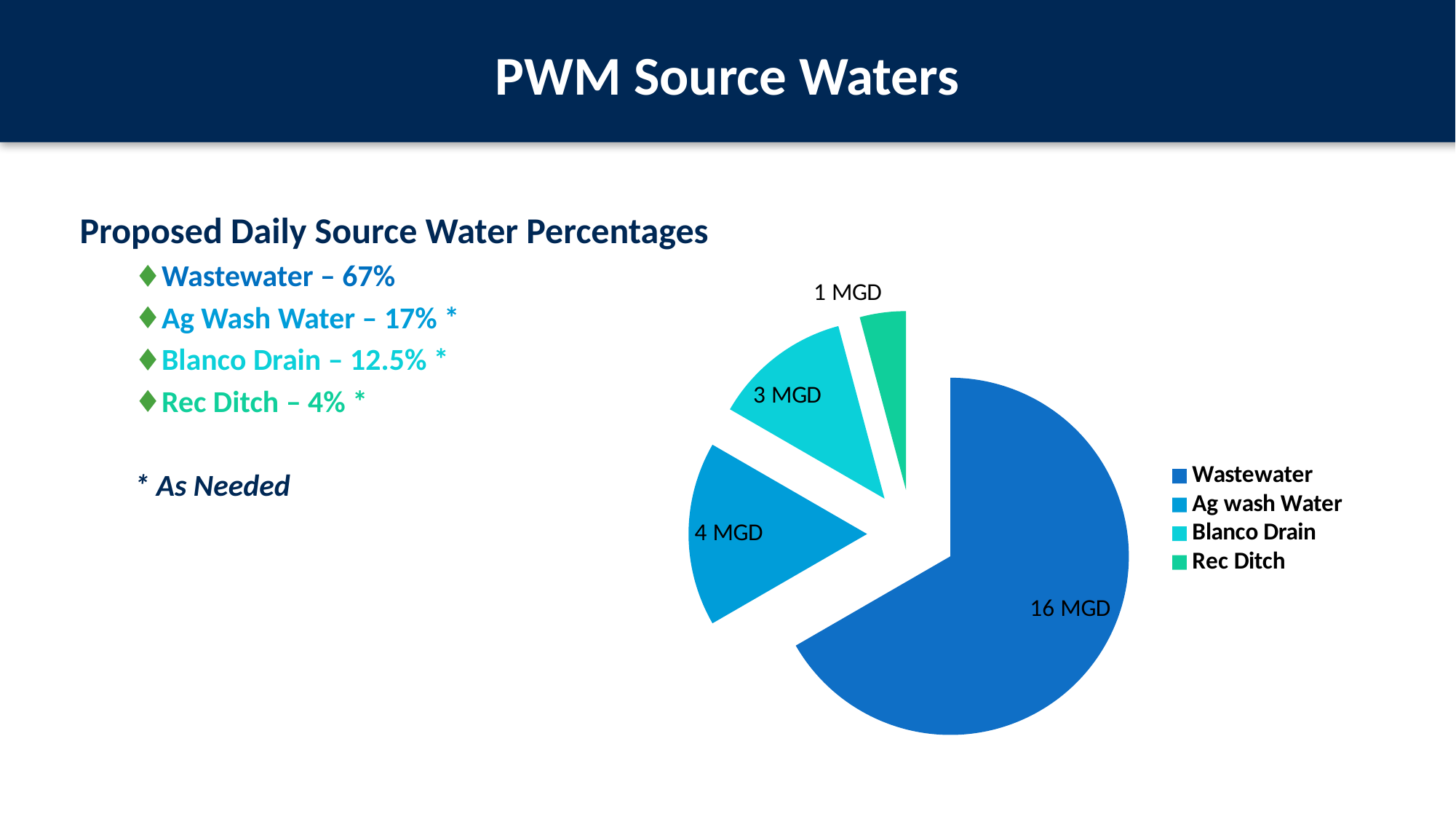
What is the value for Blanco Drain in the pie chart? 3 MGD How many slices does the pie chart have? 4 What is the value for Wastewater in the pie chart? 16 MGD Which is larger in the pie chart, Blanco Drain or Rec Ditch? Blanco Drain What is the value for Ag wash Water in the pie chart? 4 MGD Which source water has the largest slice in the pie chart? Wastewater What is the difference between the Wastewater and Ag wash Water values in the pie chart? 12 MGD What is the value for Rec Ditch in the pie chart? 1 MGD What share of the pie chart total does Blanco Drain represent? 12.5% Which source water has the smallest slice in the pie chart? Rec Ditch What kind of chart is shown on the slide? Pie chart What is the total of all the slices in the pie chart? 24 MGD